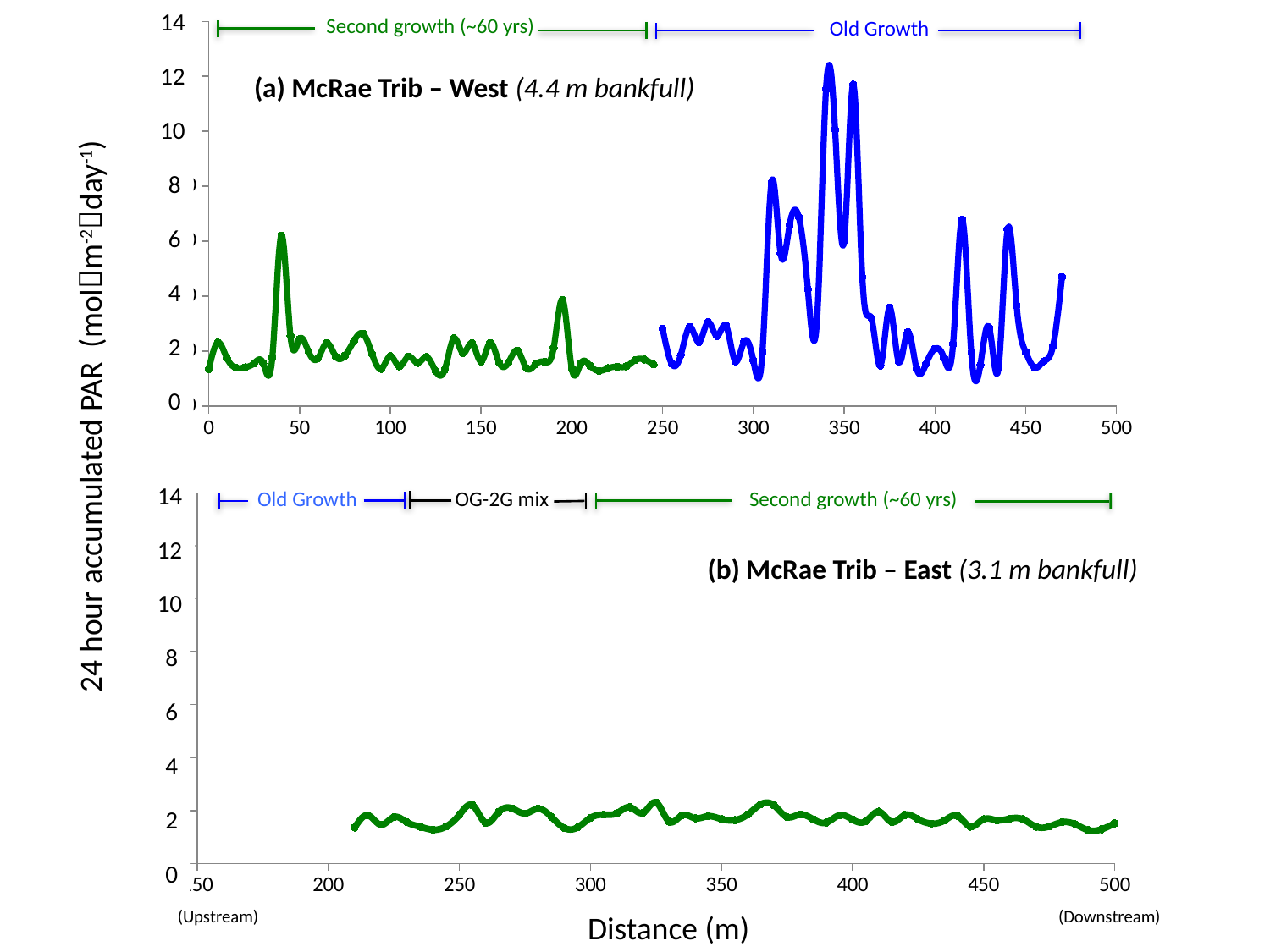
What kind of chart is chart (b) McRae Trib – East? line chart In chart (a) McRae Trib – West, is the highest peak (near 340 m) greater or less than 10? greater What bankfull width is given in the title of chart (b) McRae Trib – East? 3.1 m bankfull What is the label of the shared x axis on the slide? Distance (m) What kind of chart is chart (a) McRae Trib – West? line chart In chart (a) McRae Trib – West, is the peak near 40 m greater or less than 4? greater In chart (b) McRae Trib – East, is the highest value greater or less than 4? less Which chart reaches a higher maximum PAR value, chart (a) McRae Trib – West or chart (b) McRae Trib – East? chart (a) McRae Trib – West In chart (a) McRae Trib – West, which is larger: the peak near 40 m or the peak near 195 m? the peak near 40 m In chart (a) McRae Trib – West, which forest zone contains the highest peak, Second growth or Old Growth? Old Growth